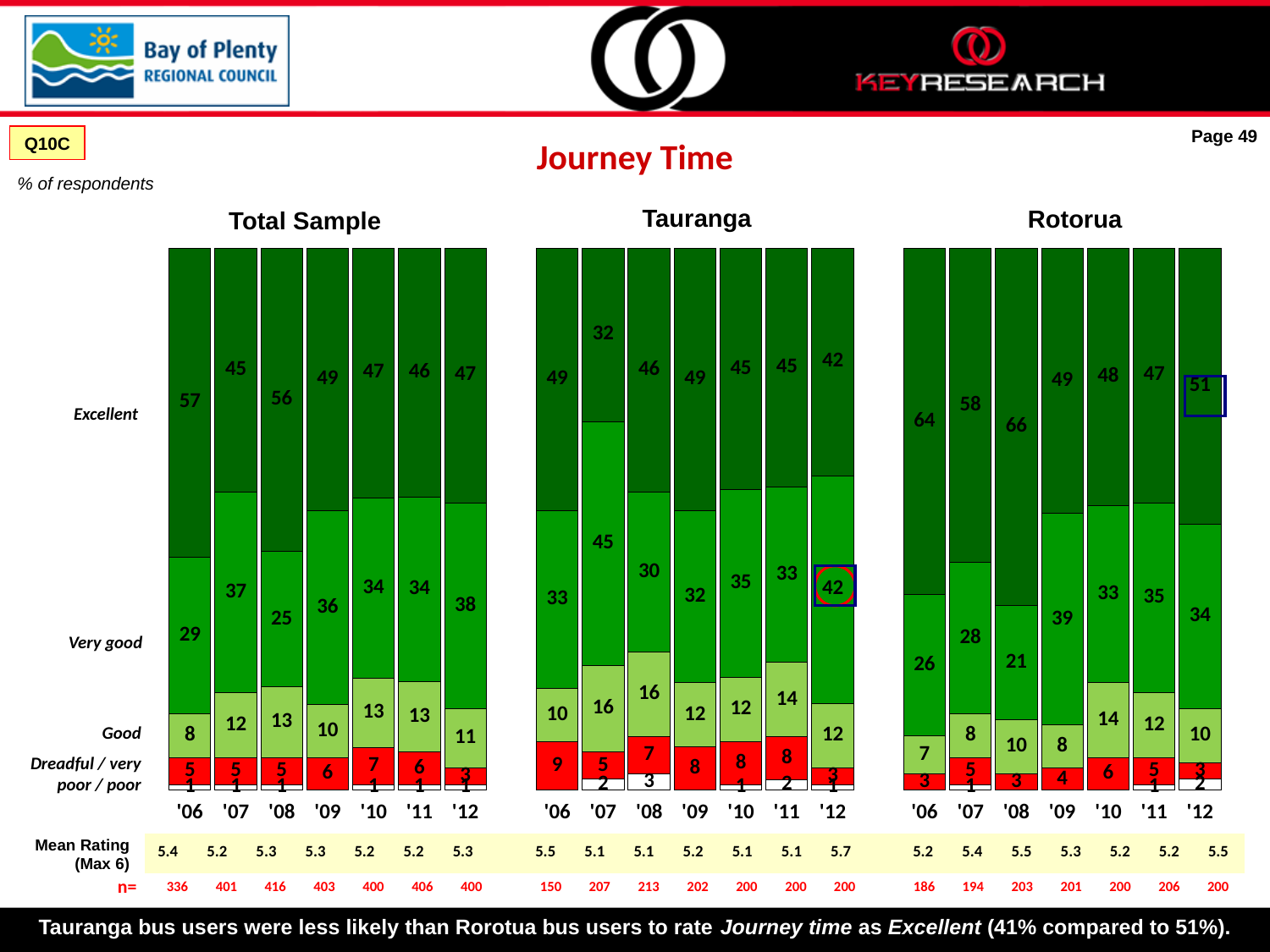
How many years are shown on the x axis of the Total Sample chart? 7 In the Rotorua chart, which year has the highest Excellent percentage? '08 In the Rotorua chart, what is the mean rating shown for '08? 5.5 In the Tauranga chart, is the Good percentage higher in '08 or in '09? '08 What type of chart is used for the Rotorua data? Stacked bar chart In the Rotorua chart, does the Very good percentage rise or fall from '06 to '09? Rise In the Total Sample chart, what is the difference between the Excellent percentage in '06 and in '07? 12 In the Tauranga chart, which year has the lowest Excellent percentage? '07 In the Tauranga chart, what is the sample size (n) for '06? 150 In the Tauranga chart, what percentage rated Journey Time as Very good in '07? 45 In the Rotorua chart, what percentage rated Journey Time as Excellent in '12? 51 In the Total Sample chart, what percentage rated Journey Time as Excellent in '06? 57